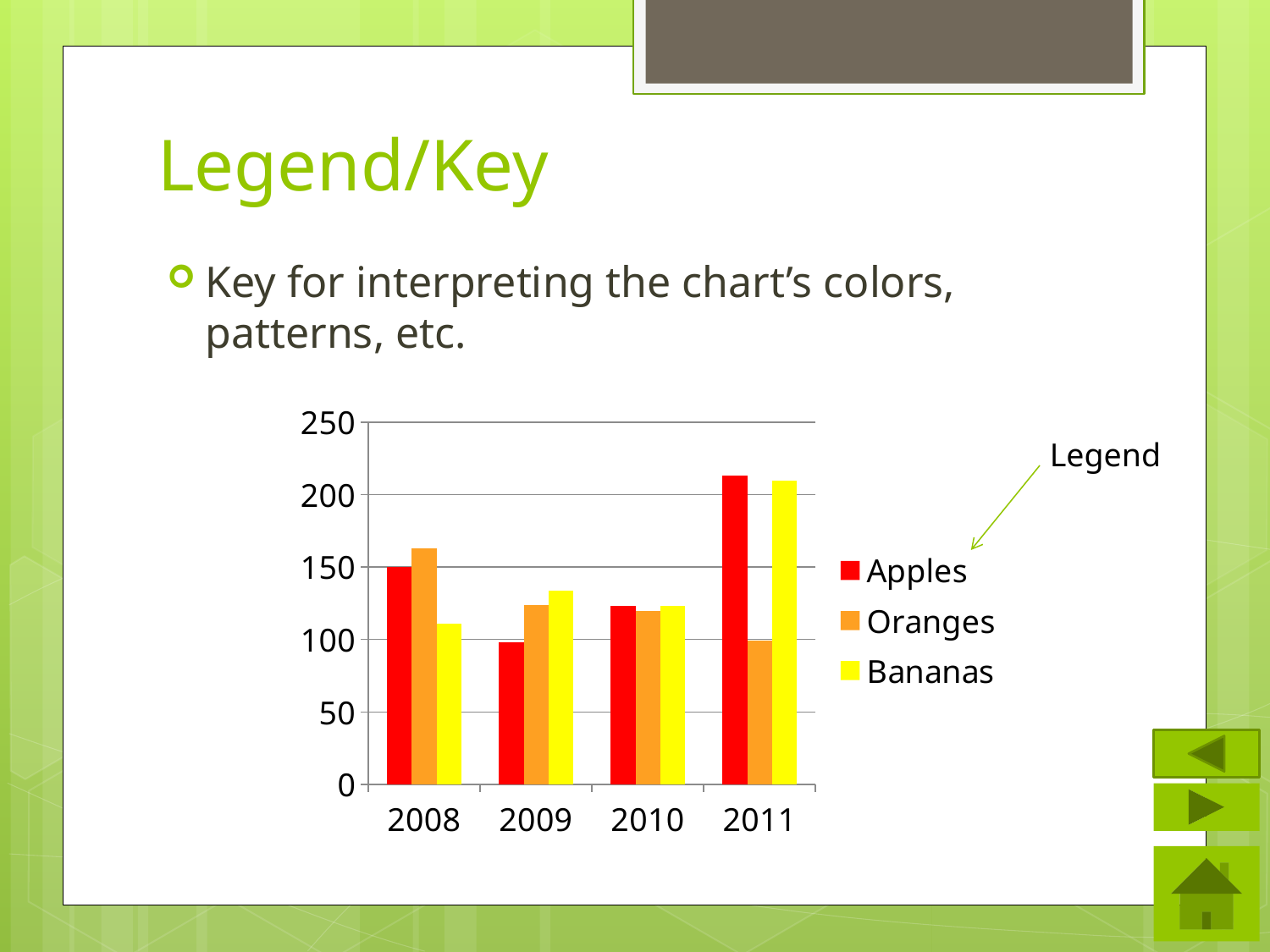
In 2011, which is larger: Apples or Oranges? Apples How many series does the chart's legend list? 3 What colour represents Apples in the chart's legend? red What kind of chart is shown on the slide? bar chart In which year is the Apples bar the lowest? 2009 Is the value for Bananas in 2011 greater or less than 200? greater How many years are shown on the x axis of the chart? 4 Is the value for Bananas in 2008 greater or less than 150? less Is the value for Apples in 2011 greater or less than 200? greater In which year is the Apples bar the highest? 2011 In 2008, which is larger: Oranges or Bananas? Oranges